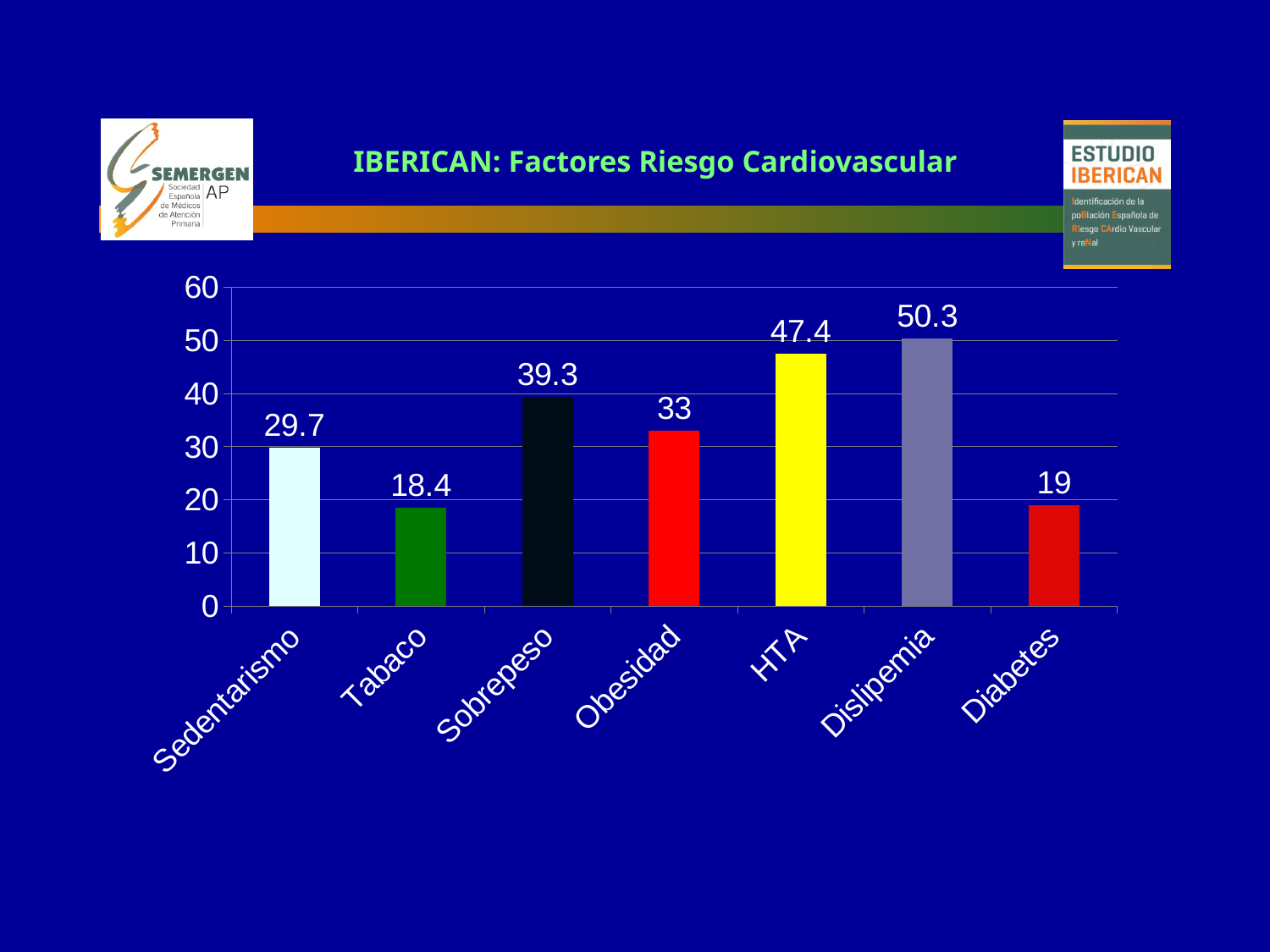
What is the title of the slide? IBERICAN: Factores Riesgo Cardiovascular What is the value for Diabetes? 19 Which category has the highest value? Dislipemia What kind of chart is shown on the slide? Bar chart Which is larger, the value for Sedentarismo or the value for Obesidad? Obesidad What is the difference between the values for Dislipemia and HTA? 2.9 What is the difference between the values for Sobrepeso and Obesidad? 6.3 What is the value for Tabaco? 18.4 What is the value for HTA? 47.4 What is the value for Sedentarismo? 29.7 How many categories are shown on the x axis? 7 Which category has the lowest value? Tabaco